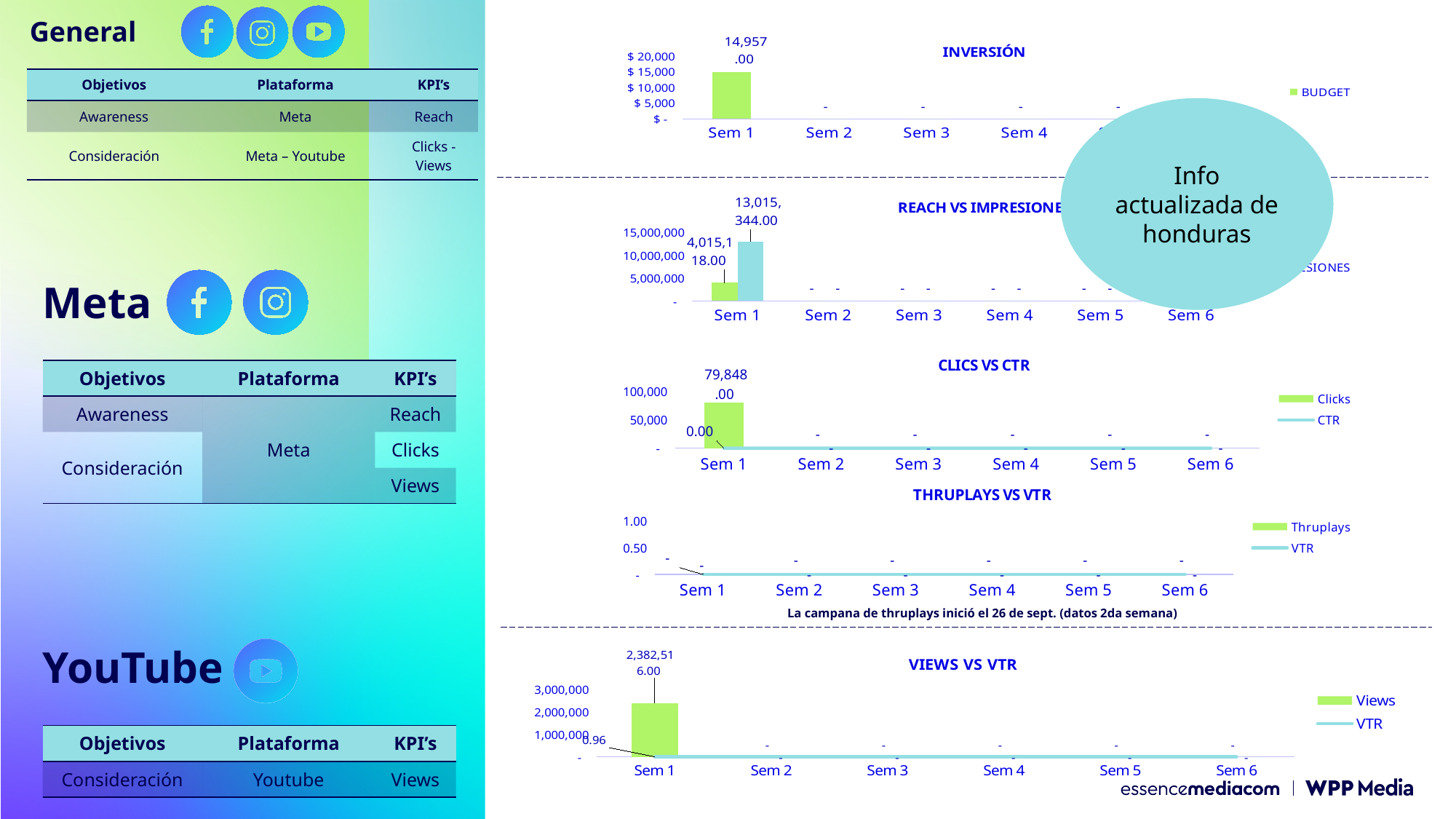
In the INVERSIÓN chart, is the value for Sem 1 greater or less than $ 10,000? greater In the VIEWS VS VTR chart, what is the VTR value for Sem 1? 0.96 In the REACH VS IMPRESIONES chart, what is the value of the taller bar for Sem 1? 13,015,344.00 In the CLICS VS CTR chart, what is the Clicks value for Sem 1? 79,848.00 In the THRUPLAYS VS VTR chart, which series does the legend list? Thruplays, VTR In the REACH VS IMPRESIONES chart, how many categories are shown on the x axis? 6 In the INVERSIÓN chart, what is the value for Sem 1? 14,957.00 In the REACH VS IMPRESIONES chart, what is the difference between the two Sem 1 values? 9,000,226.00 In the CLICS VS CTR chart, how many series does the legend list? 2 In the VIEWS VS VTR chart, what is the Views value for Sem 1? 2,382,516.00 In the REACH VS IMPRESIONES chart, what is the value of the shorter bar for Sem 1? 4,015,118.00 In the INVERSIÓN chart, which series does the legend list? BUDGET